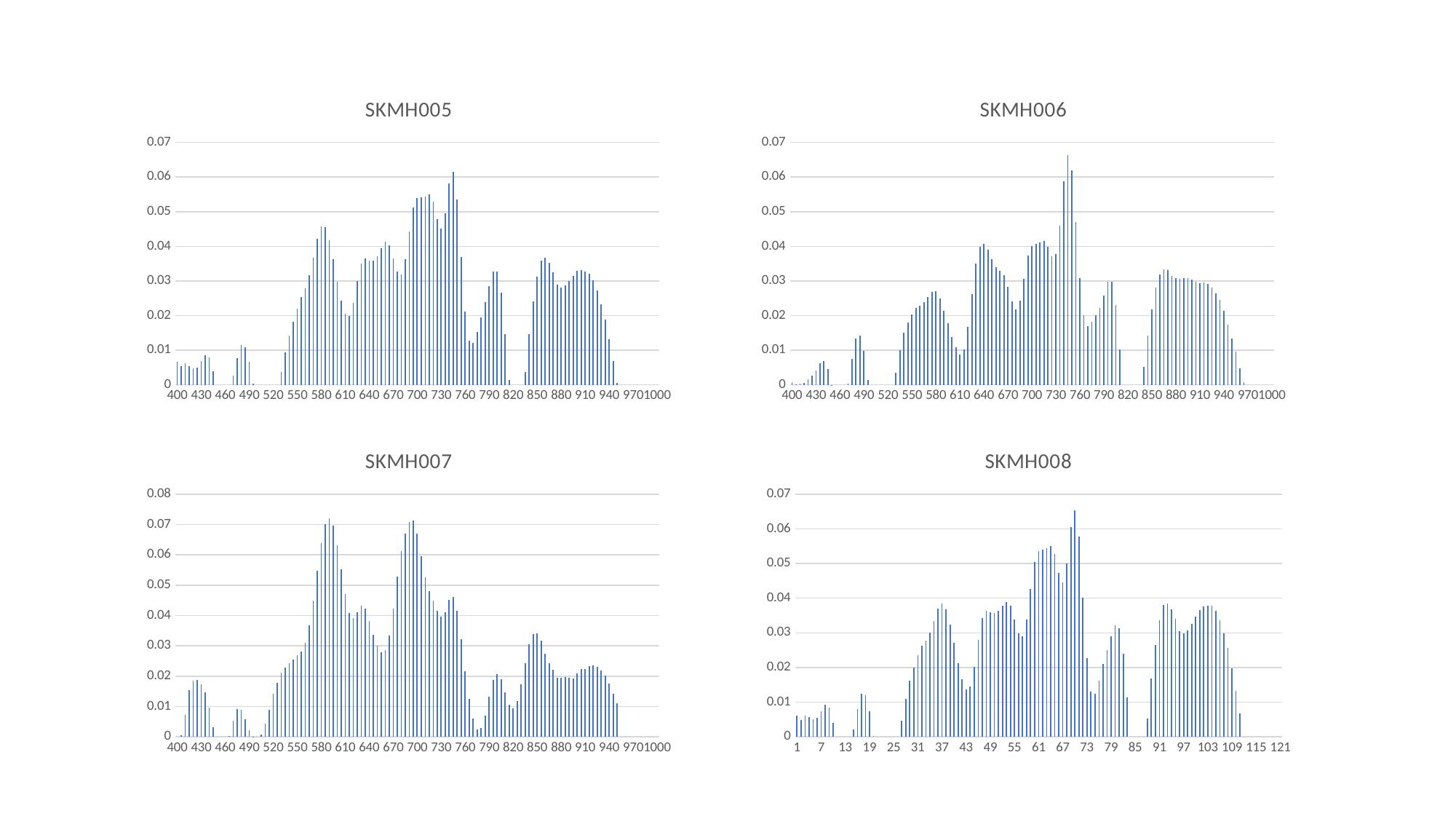
In the SKMH008 chart, is the value at about 37 on the x axis greater or less than 0.03? greater In the SKMH005 chart, is the value at about 580 on the x axis greater or less than 0.04? greater In the SKMH007 chart, is the value at about 850 on the x axis greater or less than 0.04? less How many charts are shown on the slide? 4 What kind of chart is SKMH008? bar chart Which chart has a y-axis that goes up to 0.08 rather than 0.07? SKMH007 What kind of chart is SKMH005? bar chart